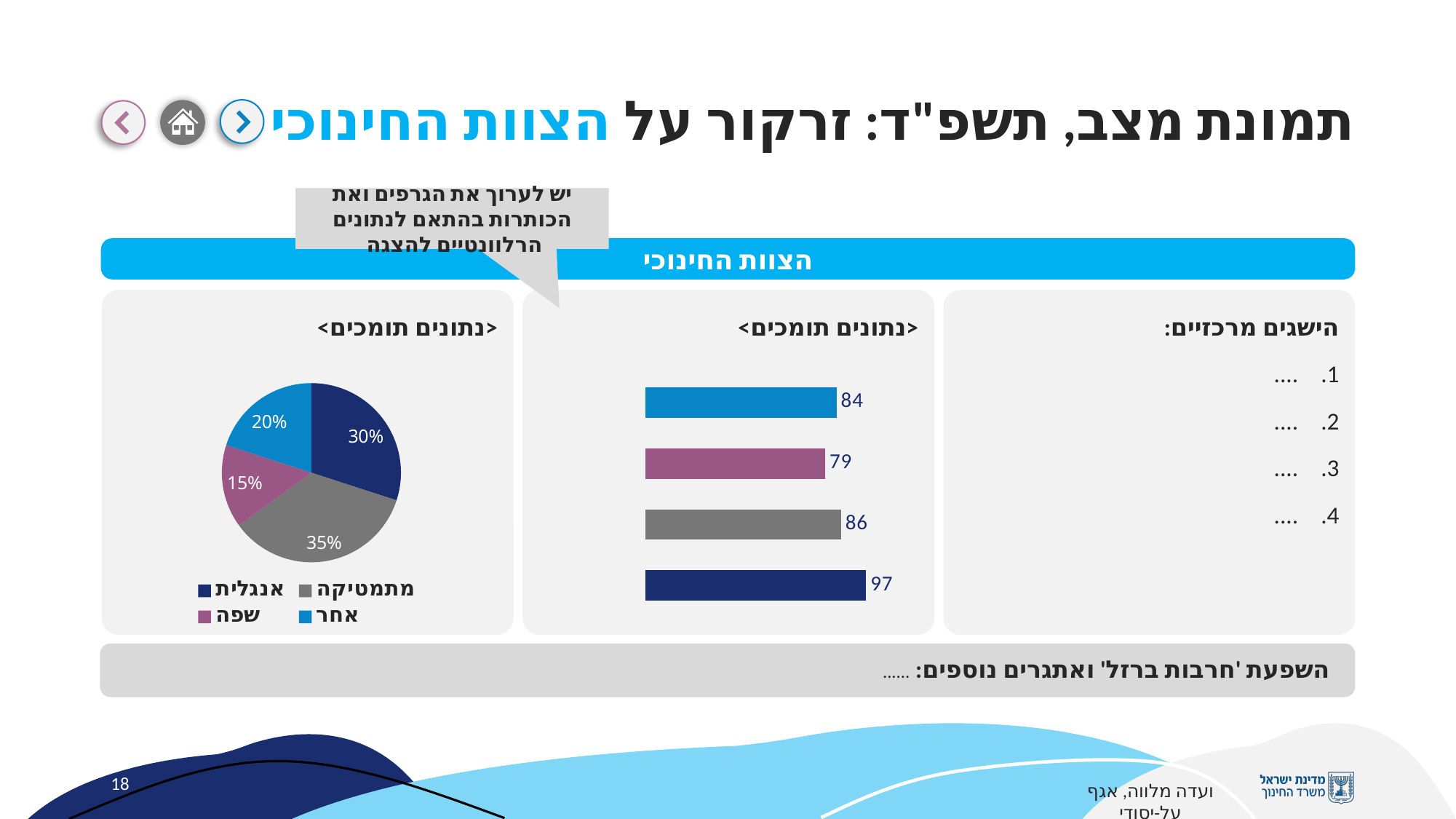
In the pie chart on the left, what is the difference between the shares of מתמטיקה and אחר? 15% In the bar chart in the middle, how many bars are there? 4 In the pie chart on the left, which category has the smallest slice? שפה In the bar chart in the middle, what is the value of the bottom (dark blue) bar? 97 In the pie chart on the left, which category has the largest slice? מתמטיקה In the pie chart on the left, how many entries does the legend list? 4 In the pie chart on the left, what share does אנגלית have? 30% What kind of chart is the chart on the left of the slide? pie chart In the pie chart on the left, what share does מתמטיקה have? 35% In the pie chart on the left, what share does שפה have? 15% What kind of chart is the chart in the middle of the slide? bar chart In the bar chart in the middle, what is the difference between the longest bar and the shortest bar? 18